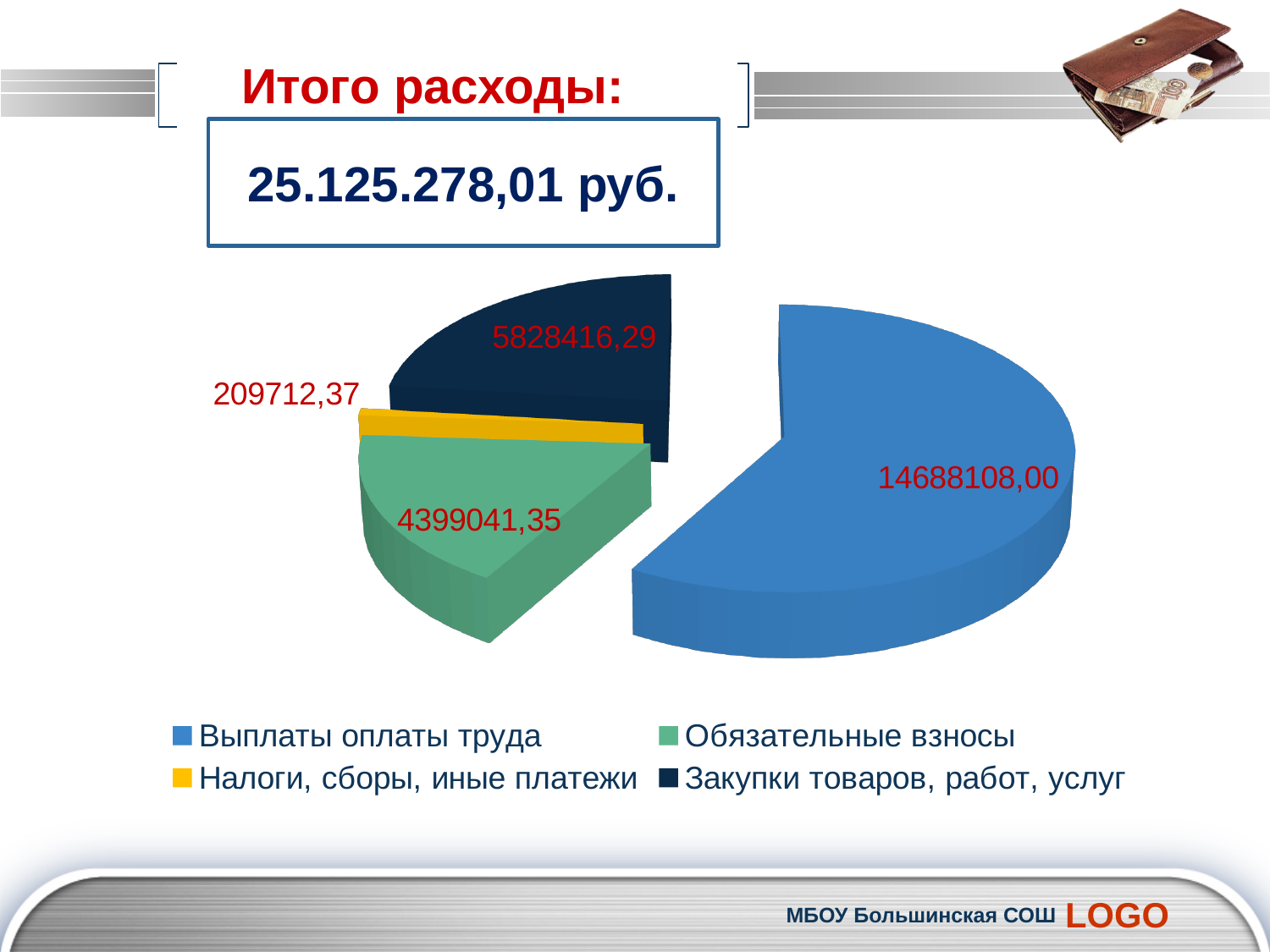
What is the difference between the Выплаты оплаты труда value and the Закупки товаров, работ, услуг value? 8859691,71 What is the value of the Выплаты оплаты труда slice? 14688108,00 Which category has the smallest slice of the pie? Налоги, сборы, иные платежи What colour is the Налоги, сборы, иные платежи slice? Yellow What is the value of the Обязательные взносы slice? 4399041,35 What kind of chart is shown on the slide? Pie chart What is the difference between the Закупки товаров, работ, услуг value and the Обязательные взносы value? 1429374,94 What is the value of the Налоги, сборы, иные платежи slice? 209712,37 Which is larger: Обязательные взносы or Закупки товаров, работ, услуг? Закупки товаров, работ, услуг How many slices does the pie chart have? 4 Which category has the largest slice of the pie? Выплаты оплаты труда What is the value of the Закупки товаров, работ, услуг slice? 5828416,29